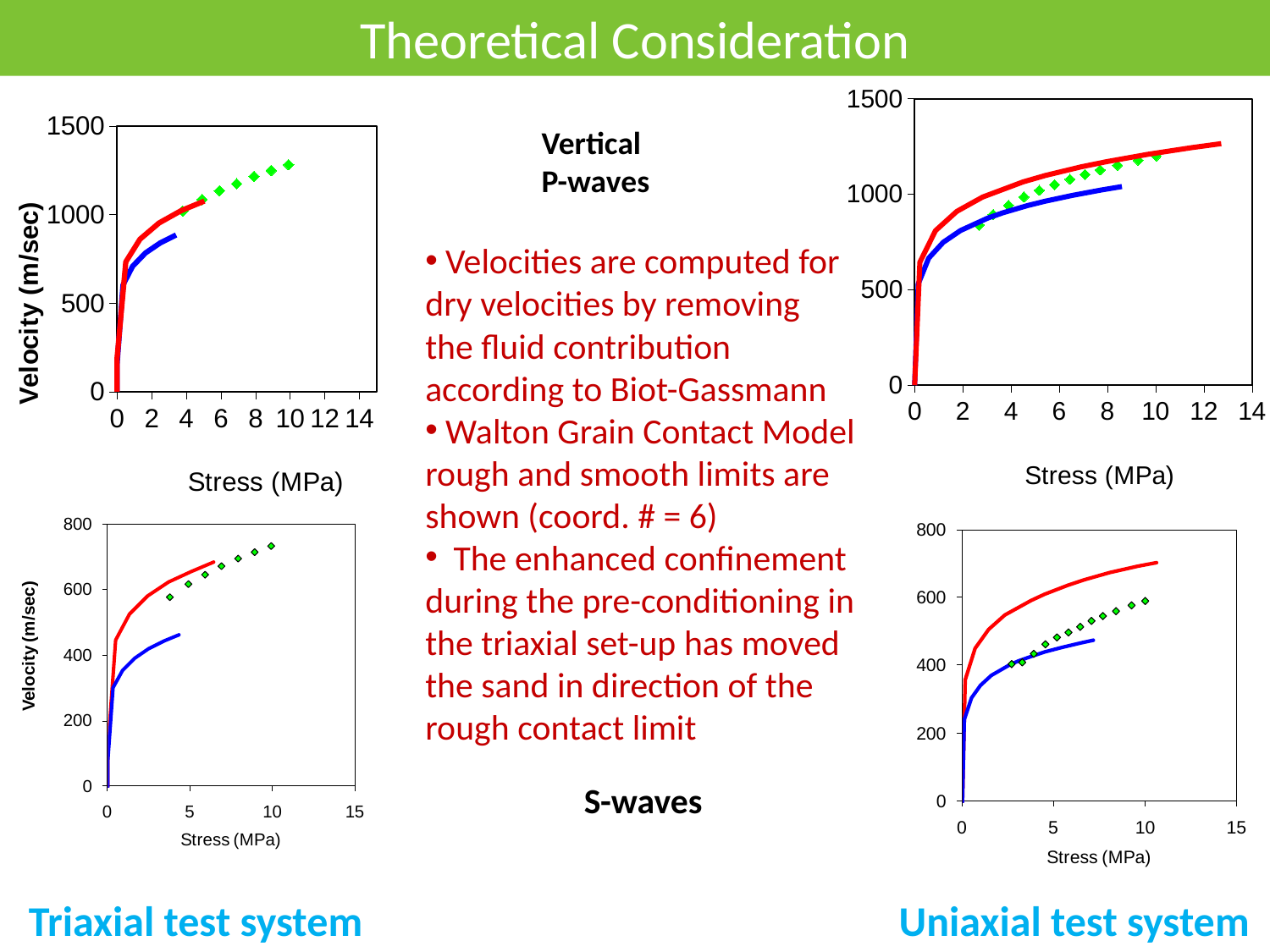
In the top-right chart (Uniaxial P-waves), at a stress of 8 MPa, which line is higher, the red line or the blue line? red line In the top-left chart (Triaxial P-waves), is the green diamond value at a stress of 10 MPa greater or less than 1000? greater In the top-left chart (Triaxial P-waves), is the highest value of the blue line greater or less than 1000? less In the top-right chart (Uniaxial P-waves), is the red line value at a stress of 12 MPa greater or less than 1000? greater How many charts are shown on the slide? 4 In the top-left chart (Triaxial P-waves), does velocity rise or fall as stress increases? rise What is the y-axis label of the top-left chart? Velocity (m/sec) What kind of chart is the top-left chart (Triaxial test system, P-waves)? line chart